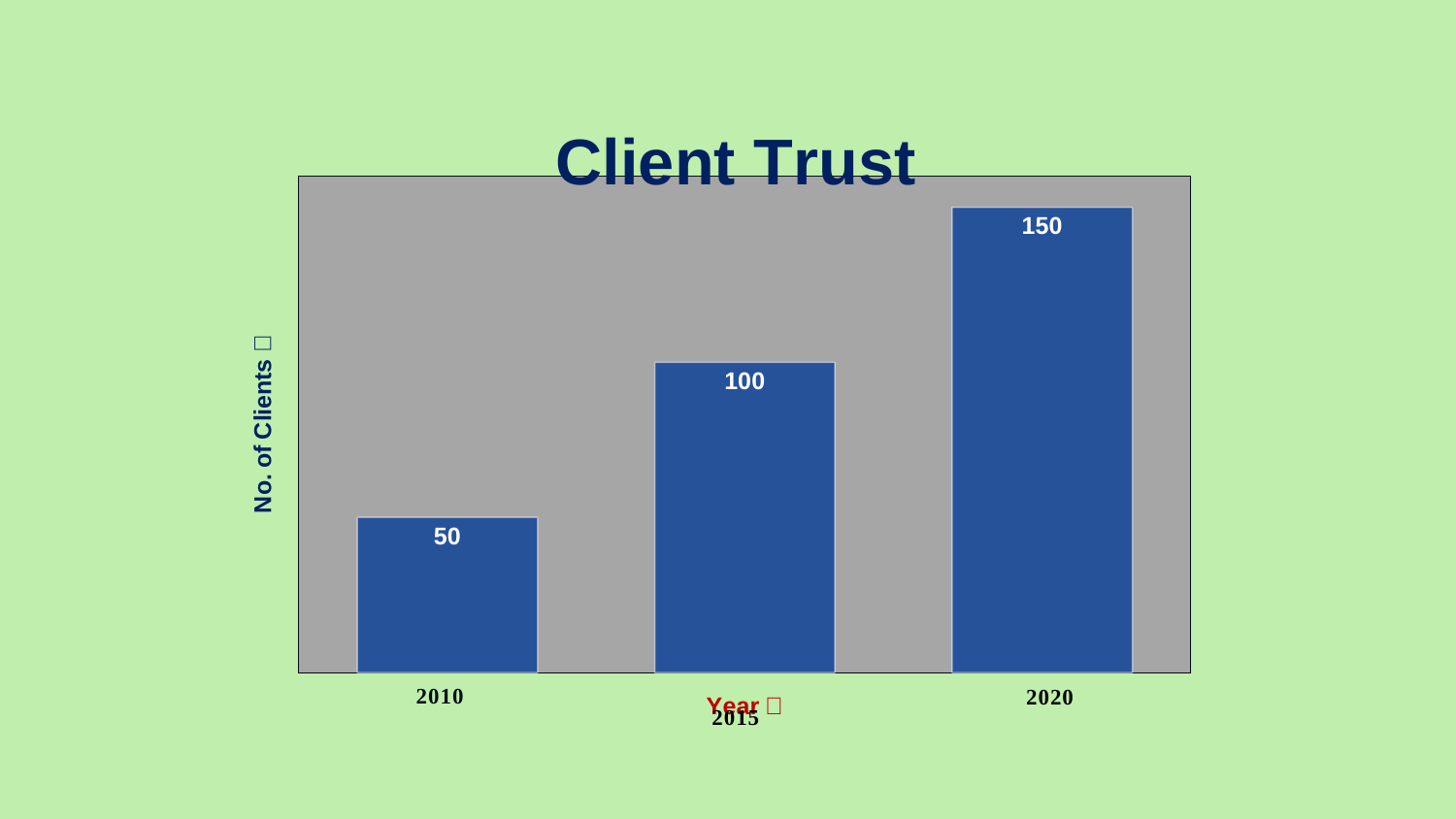
What is the difference in number of clients between 2020 and 2010? 100 Do the number of clients rise or fall from 2010 to 2020? Rise What is the difference in number of clients between 2015 and 2010? 50 What is the number of clients for 2020? 150 Which year has the lowest number of clients? 2010 What is the title of the chart? Client Trust How many years are shown on the chart? 3 What is the number of clients for 2015? 100 What kind of chart is shown on the slide? Bar chart Which year has more clients, 2015 or 2020? 2020 Which year has the highest number of clients? 2020 What is the number of clients for 2010? 50